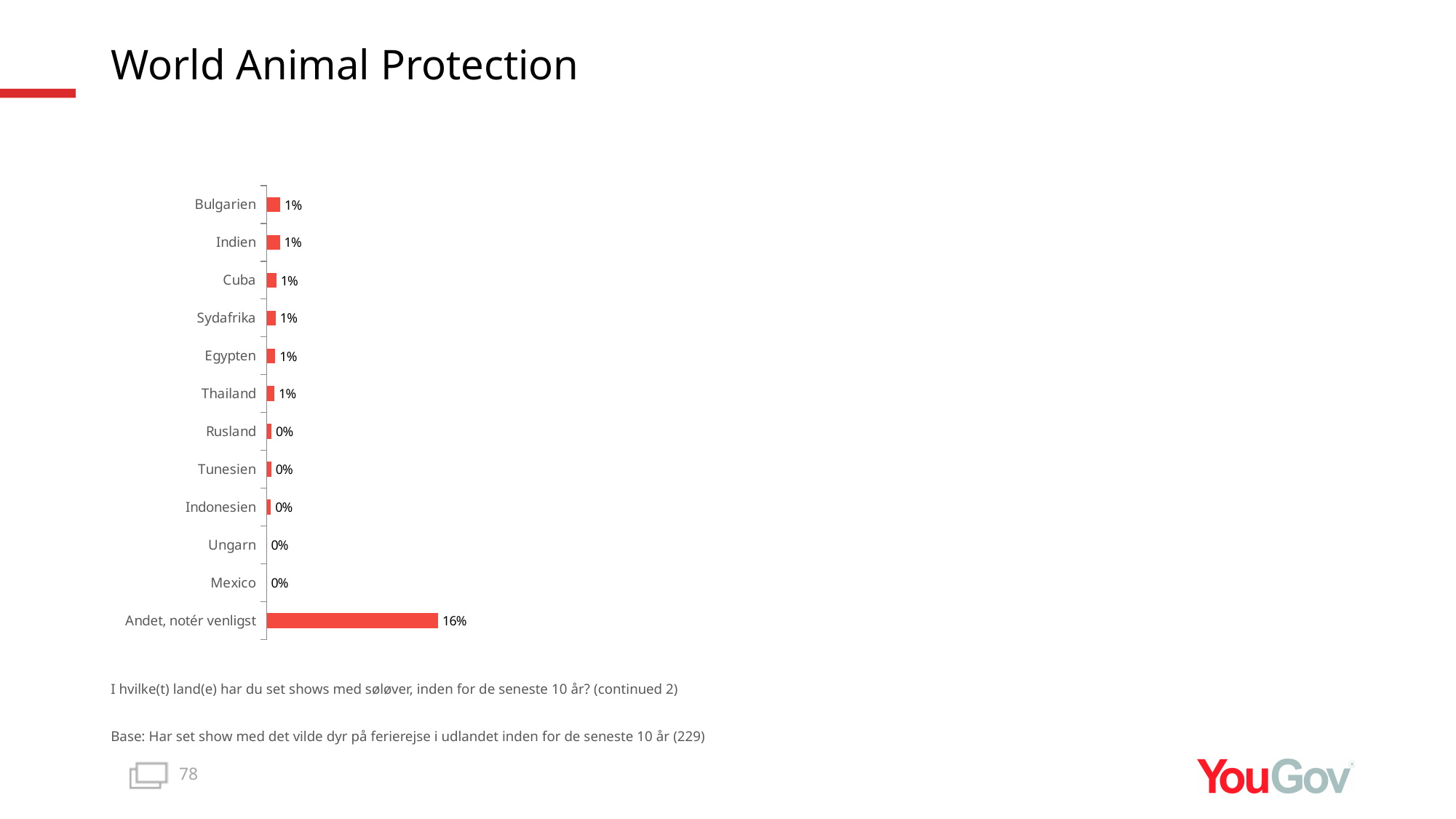
What is the base size stated below the chart? 229 What is the value for Bulgarien? 1% What is the value for Andet, notér venligst? 16% Which is larger, the value for Egypten or the value for Andet, notér venligst? Andet, notér venligst What is the value for Thailand? 1% Which category has the highest value? Andet, notér venligst What colour are the bars in the chart? Red How many categories have a value of 0%? 5 What is the value for Mexico? 0% What is the difference between the values for Andet, notér venligst and Indien? 15% How many categories are shown in the chart? 12 What kind of chart is shown on the slide? Bar chart